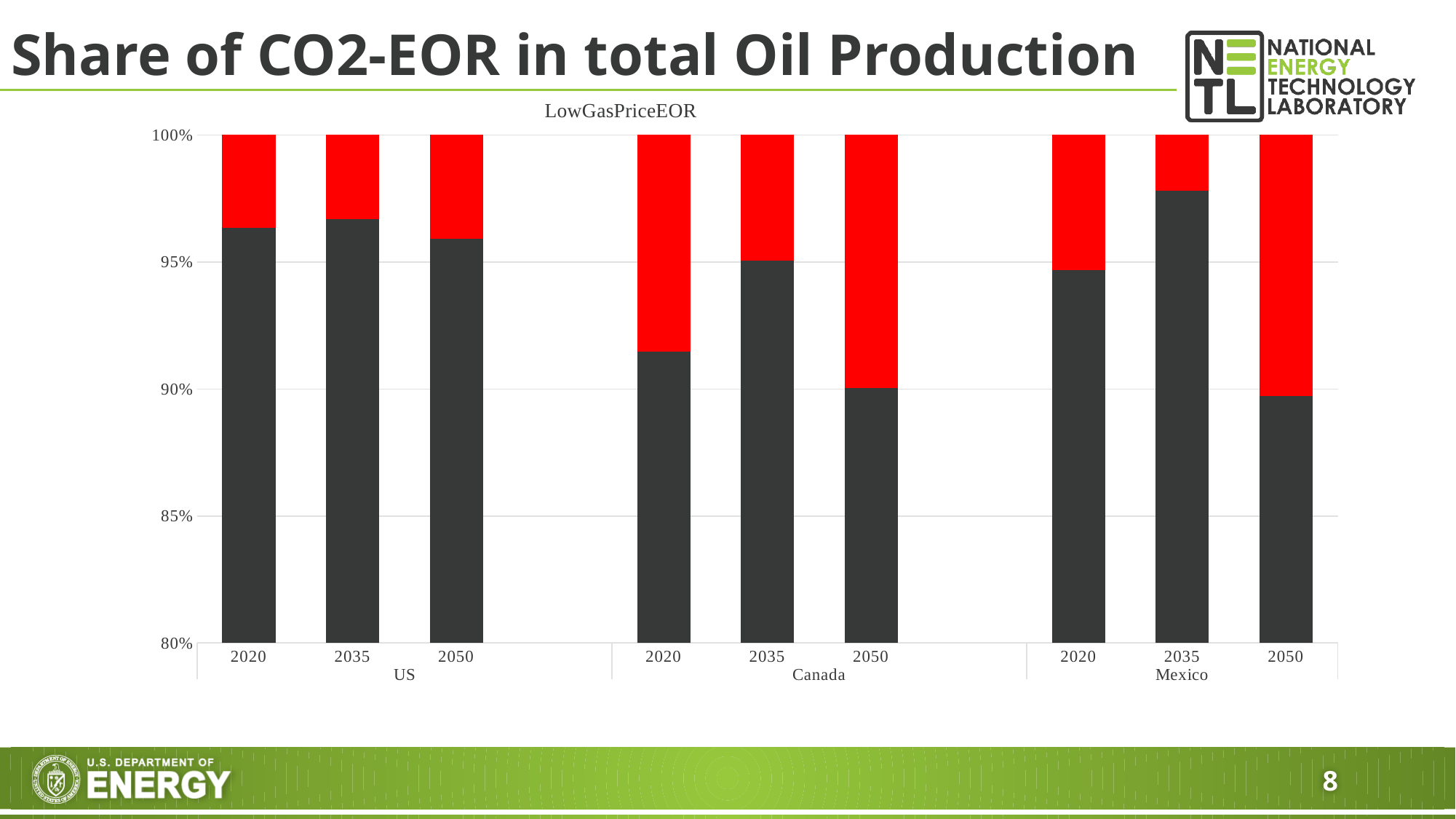
Is the dark segment for US in 2020 greater or less than 95%? greater Is the dark segment for Mexico in 2035 greater or less than 95%? greater How many bars are plotted in the chart? 9 Does the red segment for Mexico increase or decrease from 2035 to 2050? increase Is the dark segment for Canada in 2020 greater or less than 95%? less Which three countries are shown as groups on the x axis? US, Canada, Mexico Which is larger, the dark segment for US in 2020 or the dark segment for Canada in 2020? US 2020 What is the title printed above the chart? LowGasPriceEOR Which bar has the smallest red segment? Mexico 2035 What is the total of the stacked bar for US in 2020? 100% What kind of chart is shown on the slide? Stacked bar chart